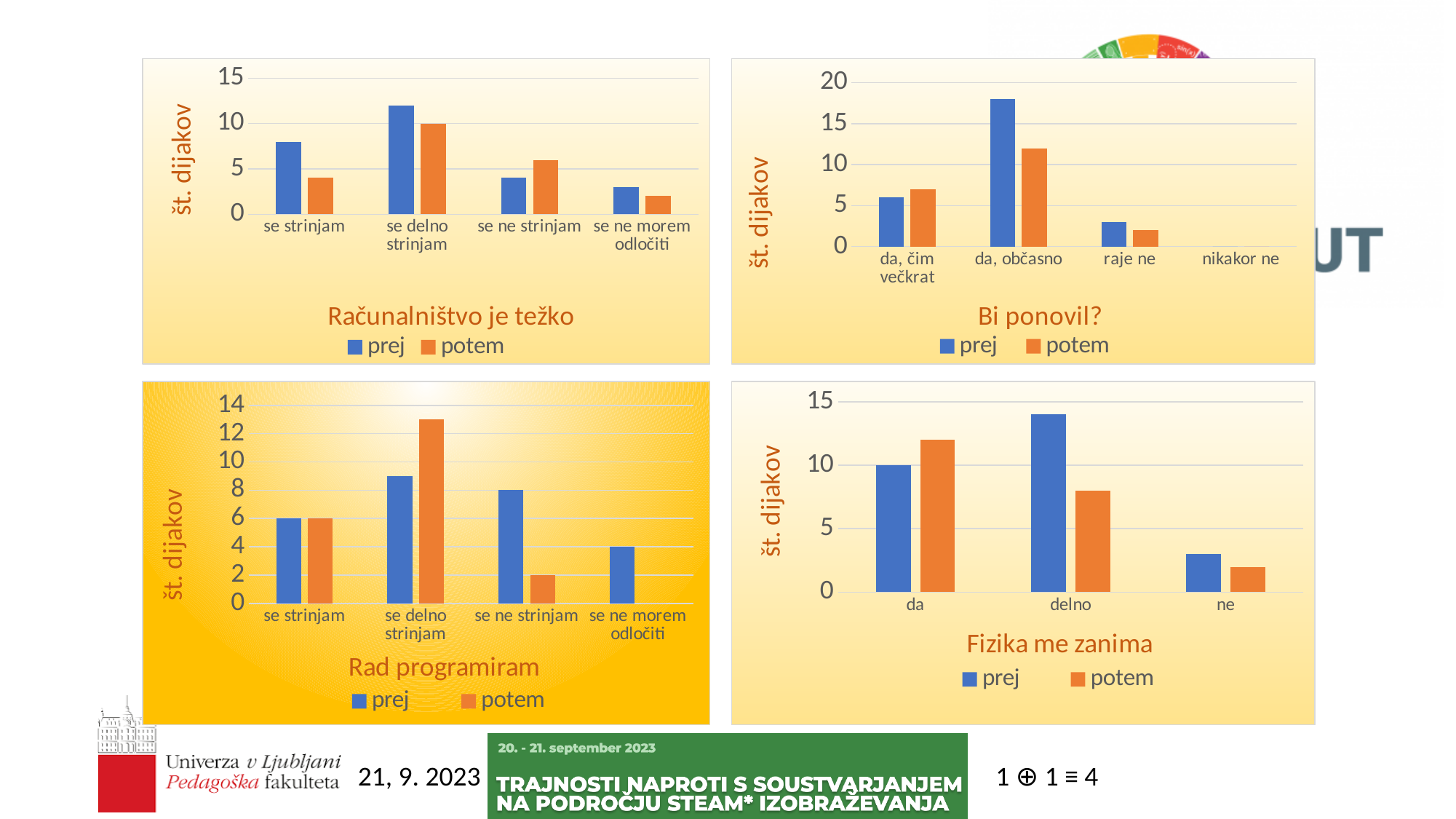
In the "Rad programiram" chart, what is the value of "prej" for "se ne morem odločiti"? 4 In the "Fizika me zanima" chart, what is the value of "prej" for "da"? 10 In the "Rad programiram" chart, what is the value of "prej" for "se ne strinjam"? 8 In the "Računalništvo je težko" chart, which is larger for "se strinjam": "prej" or "potem"? prej In the "Bi ponovil?" chart, is the "prej" value for "da, občasno" greater or less than 15? greater In the "Fizika me zanima" chart, which category has the highest "prej" value? delno In the "Računalništvo je težko" chart, is the "prej" value for "se delno strinjam" greater or less than 10? greater What kind of chart is "Rad programiram"? bar chart In the "Bi ponovil?" chart, which category has the lowest "potem" value among those with a visible bar? raje ne How many series does the legend of the "Fizika me zanima" chart list? 2 In the "Rad programiram" chart, what is the value of "potem" for "se ne strinjam"? 2 In the "Rad programiram" chart, what is the difference between "prej" and "potem" for "se ne strinjam"? 6